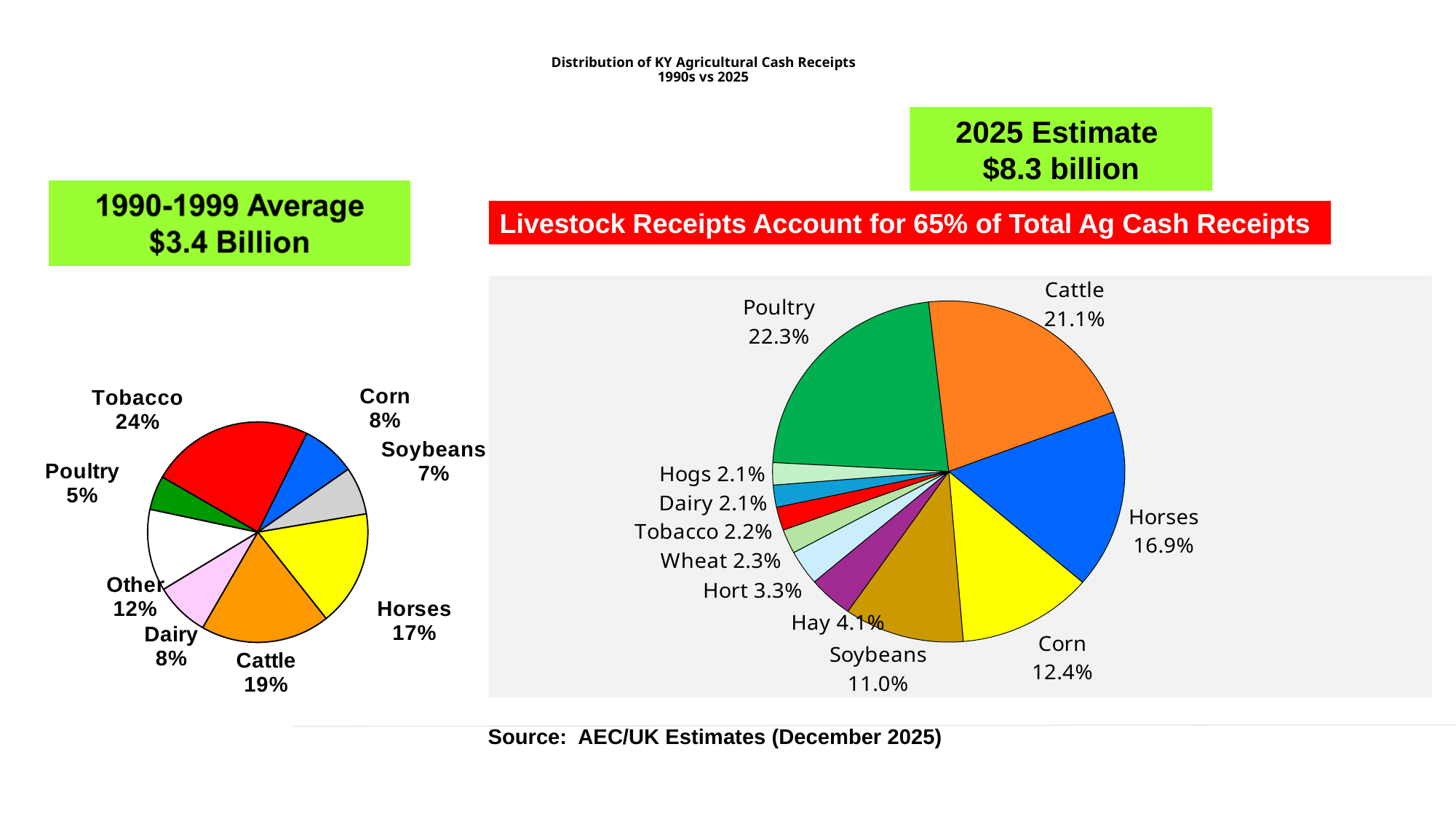
How many categories are shown in the 2025 Estimate pie chart on the right? 11 In the 2025 Estimate pie chart on the right, which category has the largest share? Poultry In the 1990-1999 Average pie chart on the left, what share does Tobacco have? 24% In the 2025 Estimate pie chart on the right, which is larger, Soybeans or Hay? Soybeans What kind of chart is used on the right side of the slide for the 2025 Estimate? Pie chart In the 2025 Estimate pie chart on the right, what share does Poultry have? 22.3% In the 1990-1999 Average pie chart on the left, which category has the largest share? Tobacco In the 1990-1999 Average pie chart on the left, which category has the smallest share? Poultry How many categories are shown in the 1990-1999 Average pie chart on the left? 8 In the 1990-1999 Average pie chart on the left, which is larger, Cattle or Horses? Cattle In the 2025 Estimate pie chart on the right, what is the difference in percentage points between Cattle and Corn? 8.7 In the 2025 Estimate pie chart on the right, what share does Horses have? 16.9%